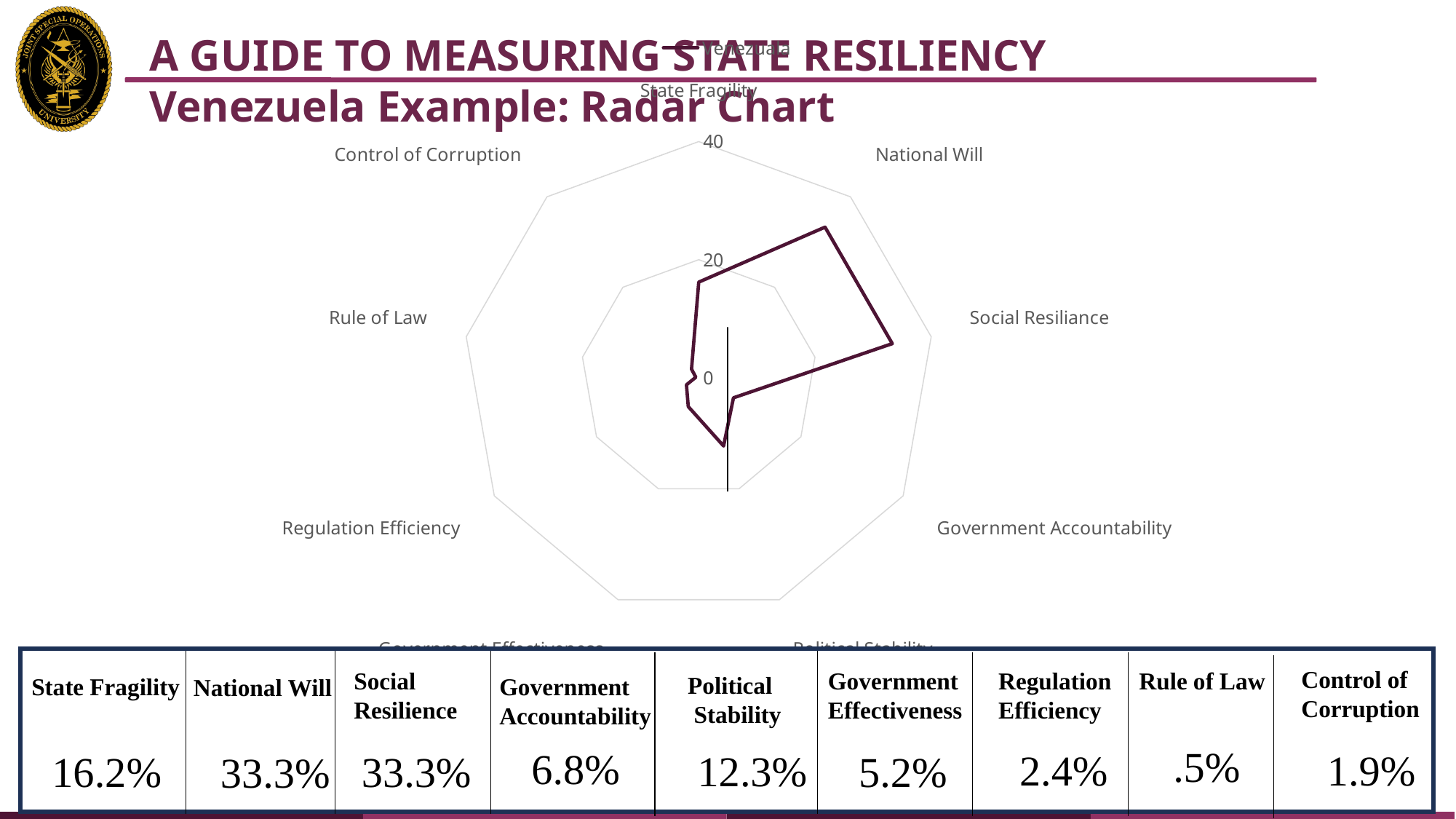
What is the value for Government Accountability? 6.8% Is the value for Social Resiliance greater or less than 20 on the radar chart's axis? greater What is the value for Regulation Efficiency? 2.4% What is the value for Control of Corruption? 1.9% What is the value for State Fragility? 16.2% Which is larger, the value for National Will or the value for Government Accountability? National Will What is the highest tick value shown on the radar chart's axis? 40 Which category has the lowest value? Rule of Law How many categories (axes) does the radar chart have? 9 What is the difference between the values for State Fragility and Political Stability? 3.9% What kind of chart is shown on the slide? Radar chart Is the value for Government Effectiveness greater or less than 20 on the radar chart's axis? less